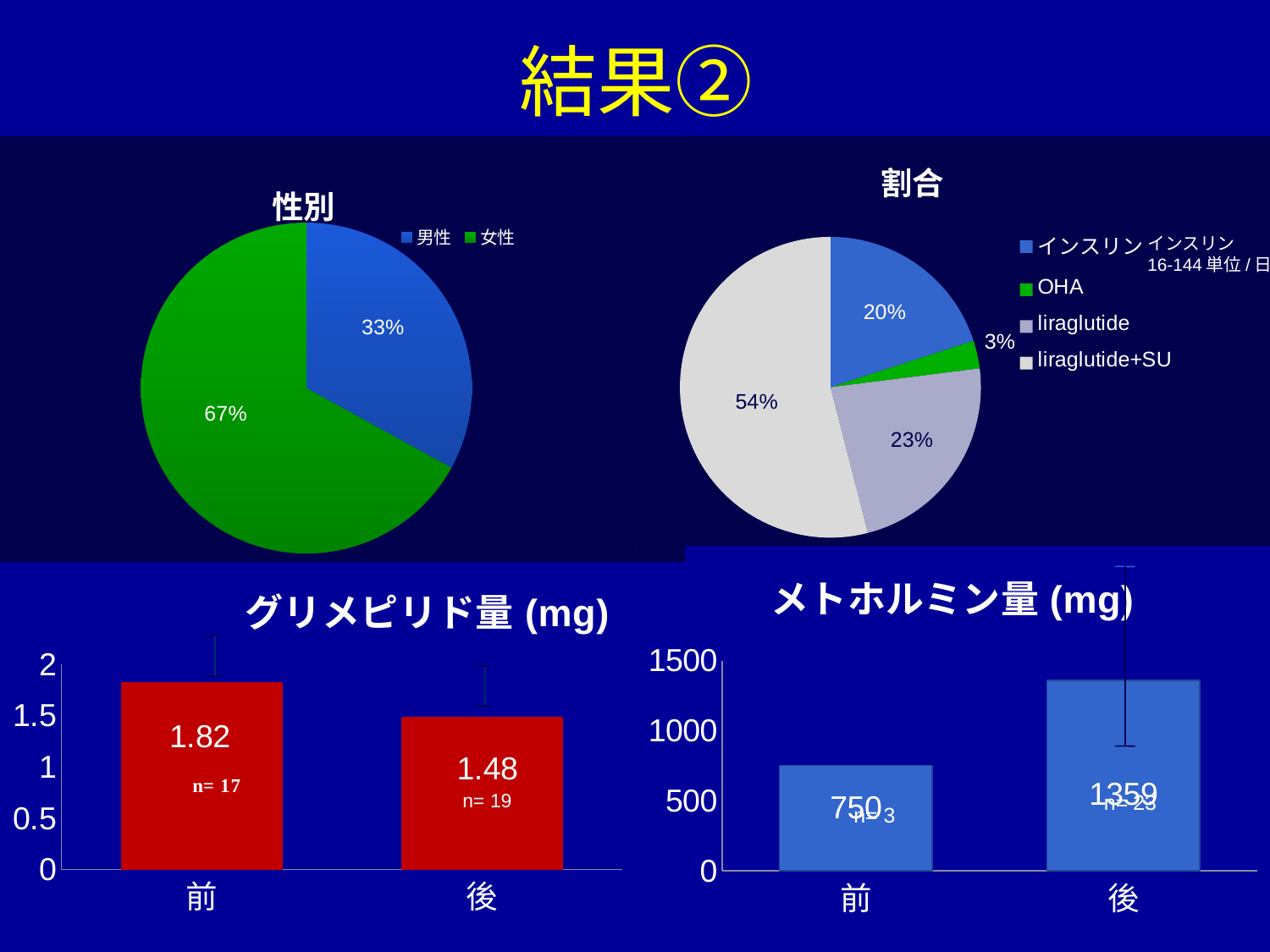
In the 割合 pie chart, what is the difference between the liraglutide share and the インスリン share? 3% In the 割合 pie chart, how many categories does the legend list? 4 In the 割合 pie chart, what share is labelled for liraglutide+SU? 54% In the 性別 pie chart, which category has the larger slice, 男性 or 女性? 女性 In the 割合 pie chart, which category has the smallest slice? OHA In the グリメピリド量 (mg) chart, what is the value for 前? 1.82 In the 性別 pie chart, what share is labelled for 男性? 33% In the 性別 pie chart, what share is labelled for 女性? 67% In the メトホルミン量 (mg) chart, what is the value for 後? 1359 What kind of chart is the メトホルミン量 (mg) chart? bar chart In the グリメピリド量 (mg) chart, do the values rise or fall from 前 to 後? fall In the グリメピリド量 (mg) chart, what is the difference between the 前 and 後 values? 0.34